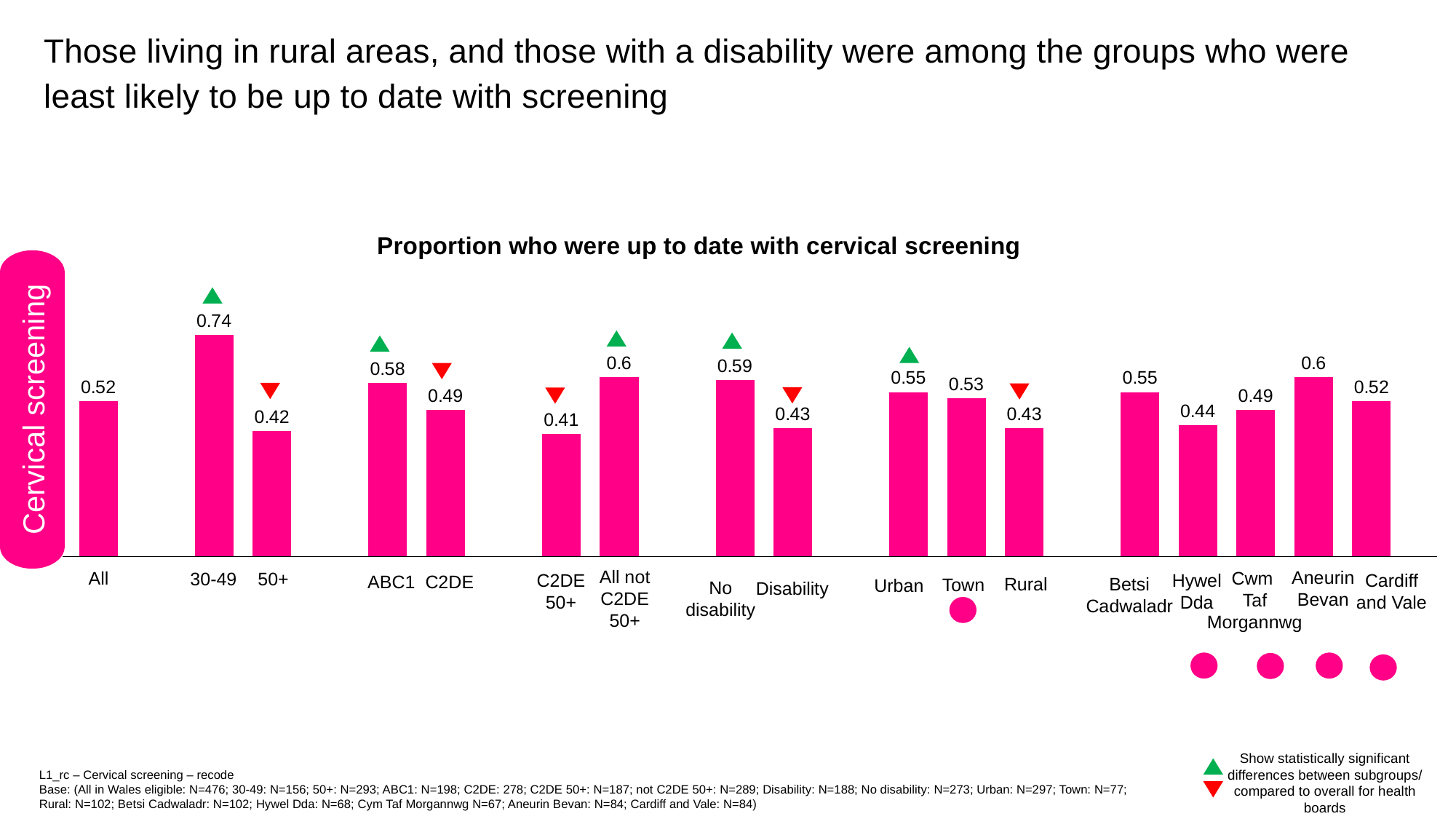
What is the difference between the values for No disability and Disability? 0.16 What kind of chart is shown? Bar chart How many categories are plotted on the chart? 17 What is the value for the All group? 0.52 Which category has the highest value? 30-49 Which is larger, the value for Urban or the value for Rural? Urban What is the value for the 30-49 group? 0.74 Which category has the lowest value? C2DE 50+ What is the value for Rural? 0.43 What is the title of the chart? Proportion who were up to date with cervical screening What is the value for Hywel Dda? 0.44 What is the difference between the values for 30-49 and 50+? 0.32